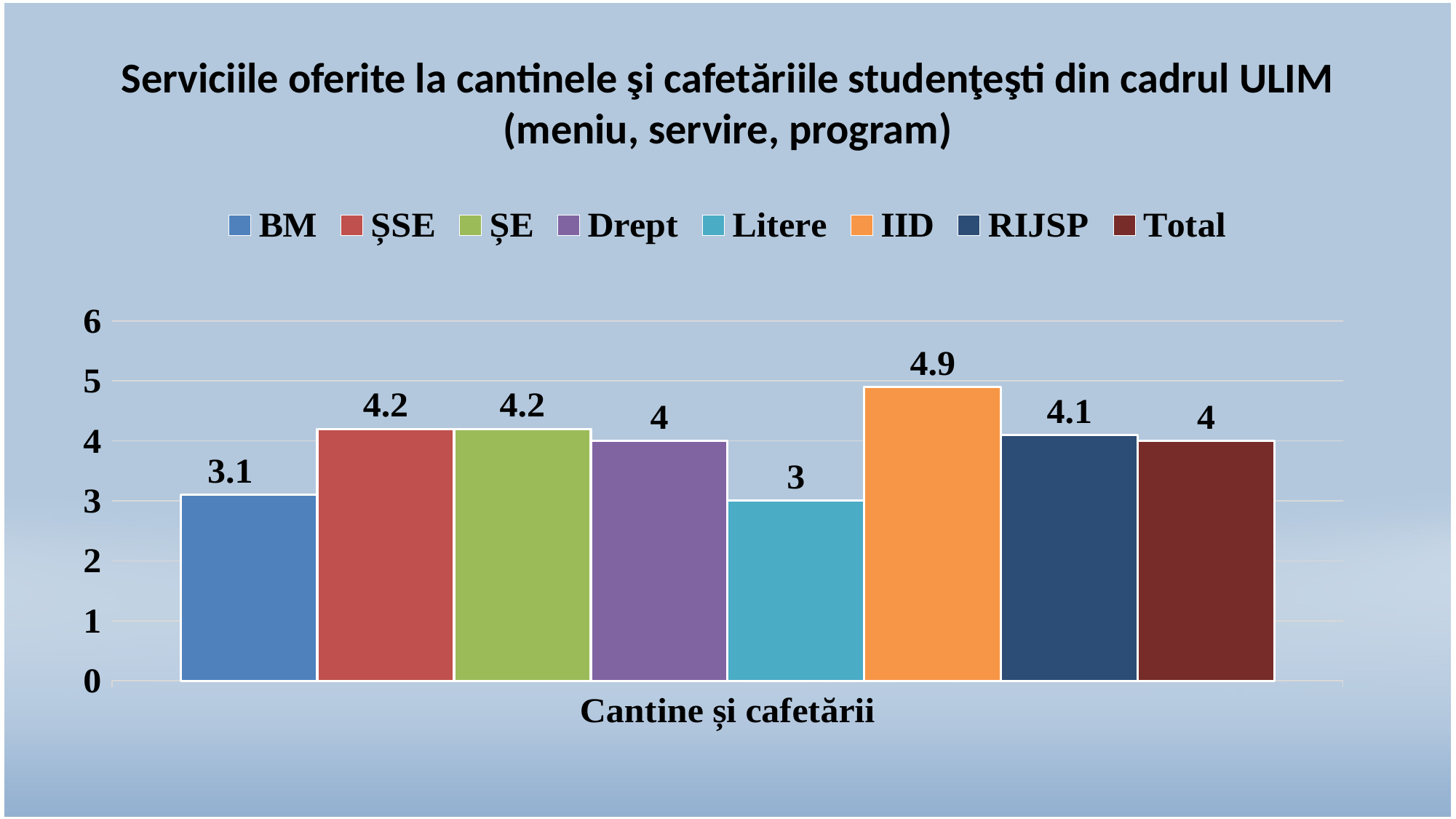
What kind of chart is shown on the slide? bar chart Which is larger, the value for ȘSE or the value for Drept? ȘSE What is the difference between the values for IID and BM? 1.8 How many series does the legend list? 8 Is the value for Total greater or less than 3? greater Which series has the lowest value? Litere What is the value for Litere? 3 What is the x-axis label of the chart? Cantine și cafetării What is the value for RIJSP? 4.1 What is the value for BM? 3.1 What is the value for IID? 4.9 Which series has the highest value? IID